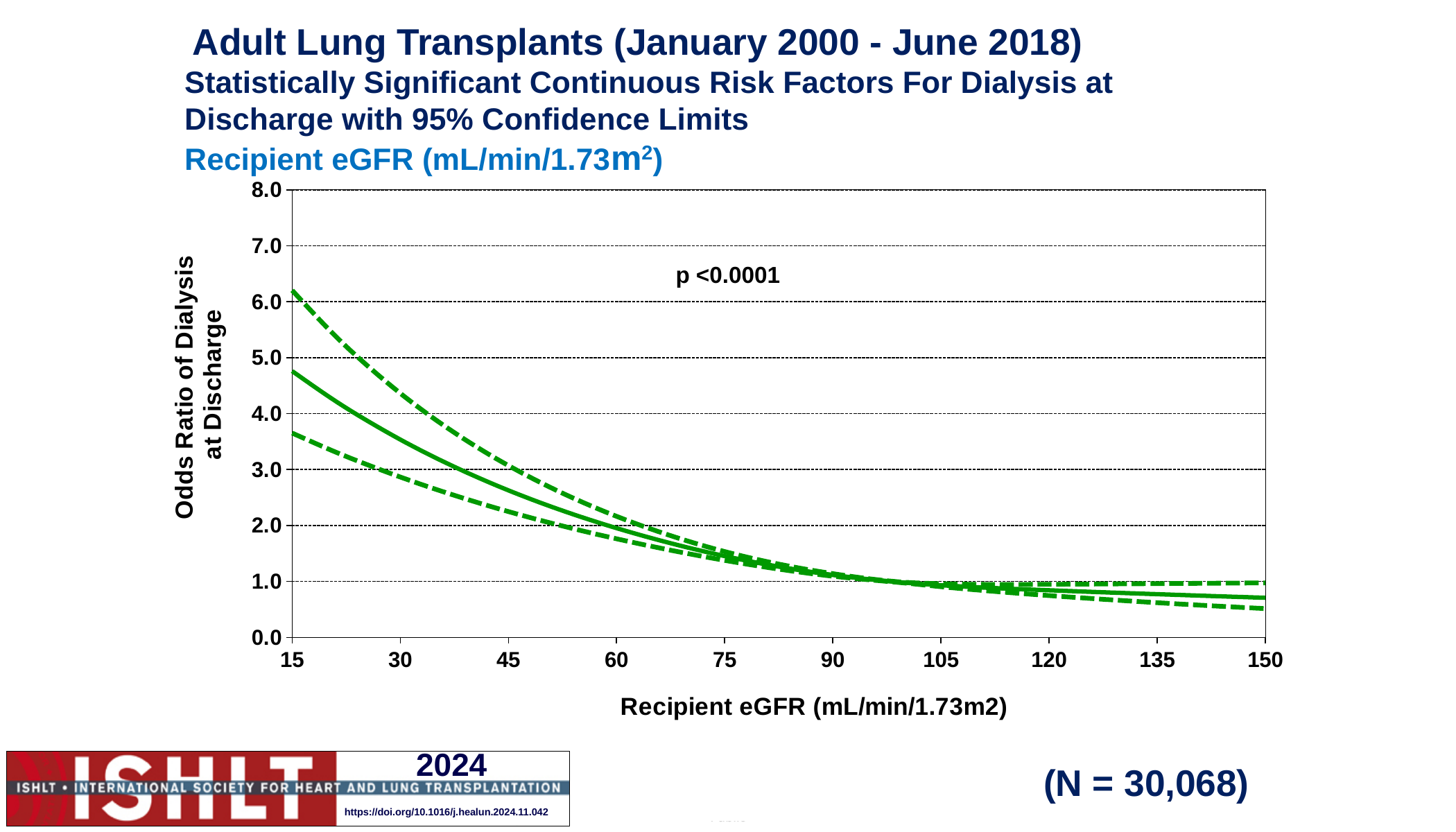
Is the odds ratio (solid line) at a recipient eGFR of 15 greater or less than 4.0? greater Is the odds ratio (solid line) at a recipient eGFR of 90 greater or less than 2.0? less What p-value is printed on the chart? p <0.0001 Is the odds ratio (solid line) at a recipient eGFR of 150 greater or less than 1.0? less Does the odds ratio of dialysis at discharge rise or fall as recipient eGFR increases along the x axis? fall How many tick labels are shown on the x axis? 10 How many lines are plotted on the chart? 3 What kind of chart is shown on the slide? line chart What is the label of the y axis? Odds Ratio of Dialysis at Discharge